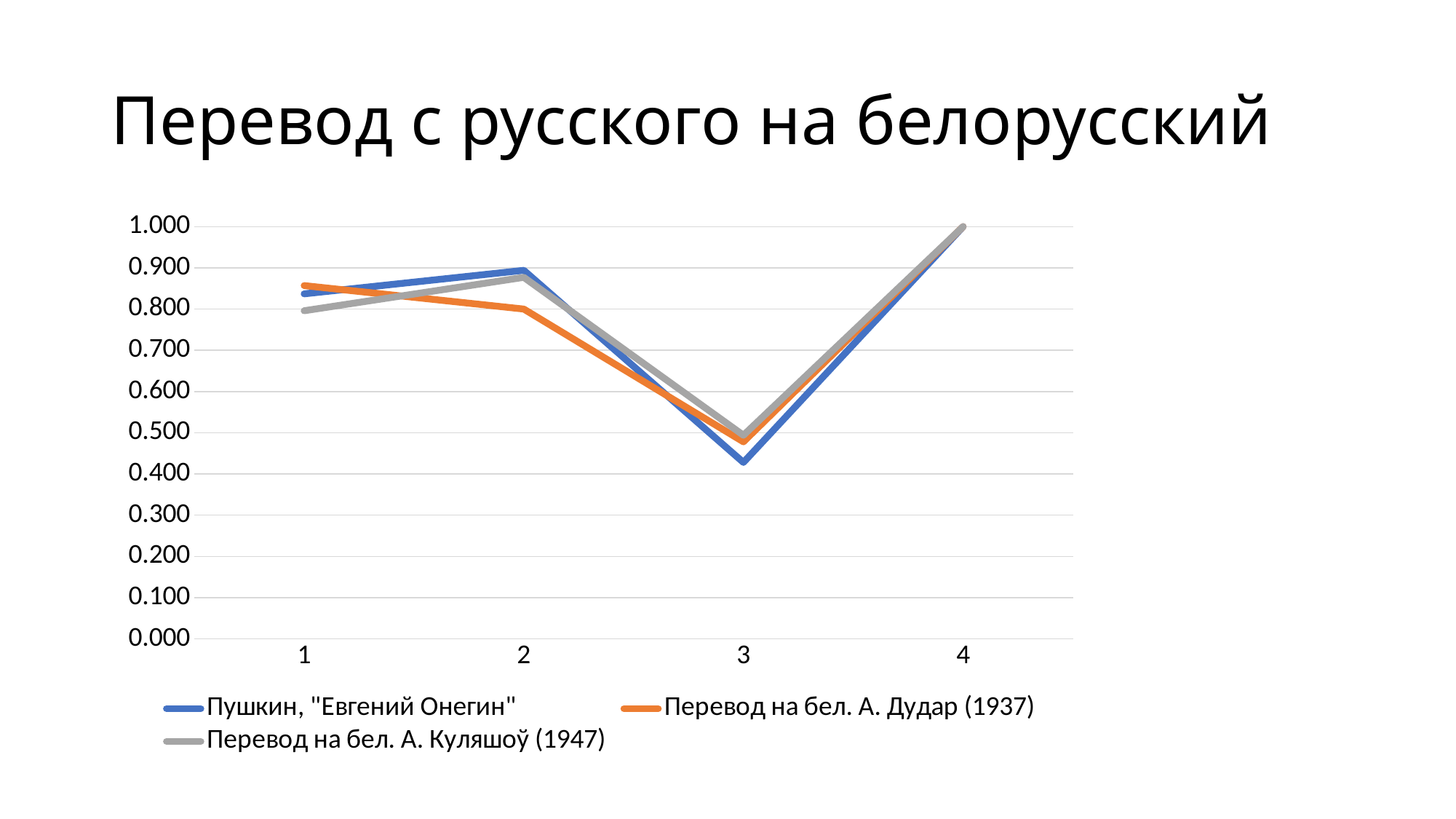
Do the values of the series Перевод на бел. А. Дудар (1937) rise or fall from point 2 to point 3? fall Is the value for Пушкин, "Евгений Онегин" at point 3 greater or less than 0.500? less How many points are plotted along the x axis for each series? 4 At point 1, which series has the larger value: Перевод на бел. А. Дудар (1937) or Перевод на бел. А. Куляшоў (1947)? Перевод на бел. А. Дудар (1937) How many series does the legend list? 3 What kind of chart is shown on the slide? line chart Is the value for Перевод на бел. А. Куляшоў (1947) at point 2 greater or less than 0.800? greater At which x-axis point does the series Перевод на бел. А. Дудар (1937) reach its highest value? 4 At point 3, which series has the larger value: Пушкин, "Евгений Онегин" or Перевод на бел. А. Куляшоў (1947)? Перевод на бел. А. Куляшоў (1947) What is the value of the series Пушкин, "Евгений Онегин" at point 4? 1.000 At which x-axis point does the series Пушкин, "Евгений Онегин" reach its lowest value? 3 What is the title of the slide? Перевод с русского на белорусский